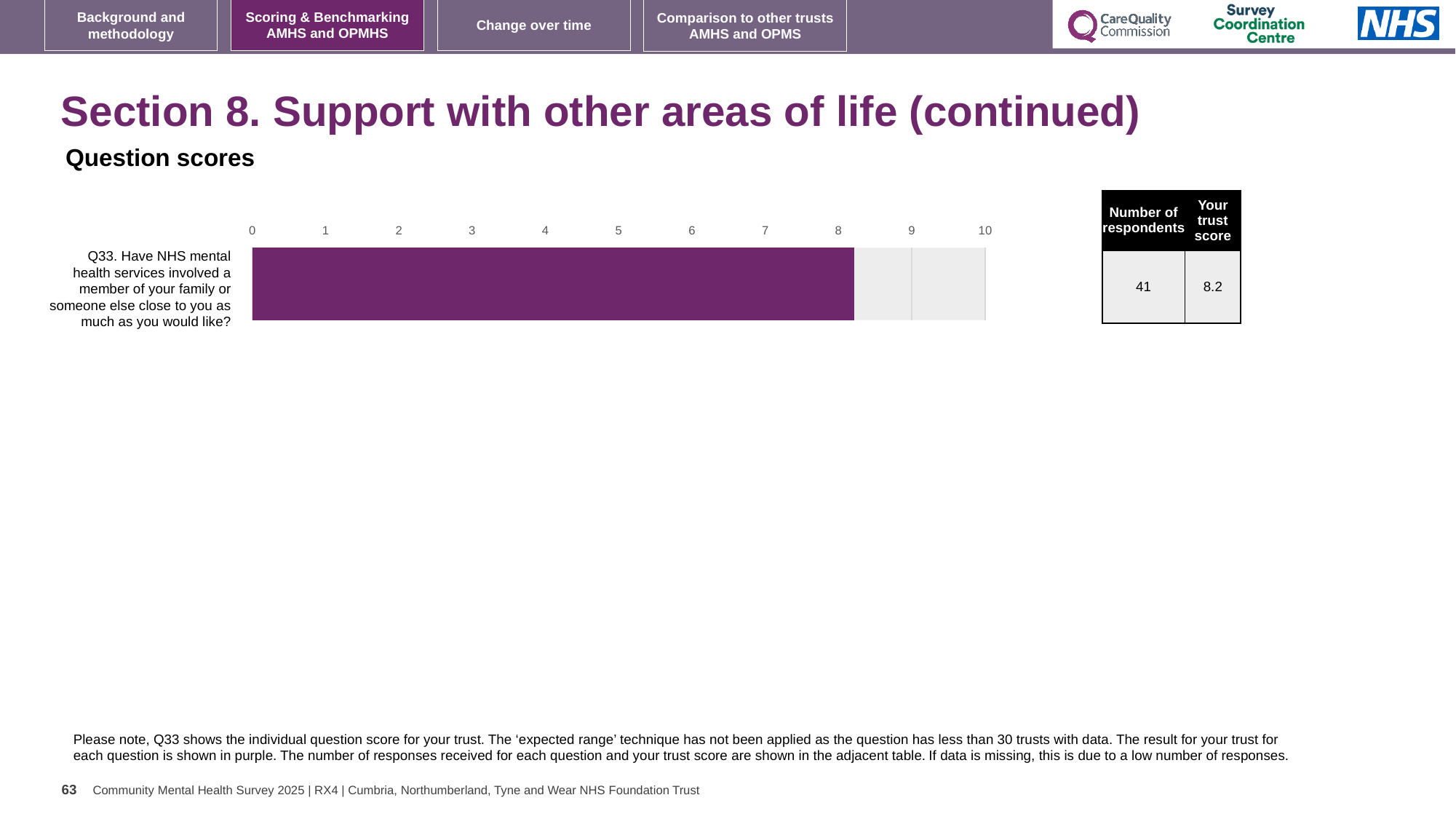
What is the number of respondents for Q33 shown in the table? 41 Is the value of the bar for Q33 greater or less than 9? less Is the value of the bar for Q33 greater or less than 5? greater What colour is the bar showing the trust's result for Q33? purple How many questions (categories) are plotted in the chart? 1 What kind of chart is shown on the slide? bar chart What is the trust score for Q33 shown in the adjacent table? 8.2 Is the value of the bar for Q33 greater or less than 8? greater What is the maximum value shown on the chart's axis? 10